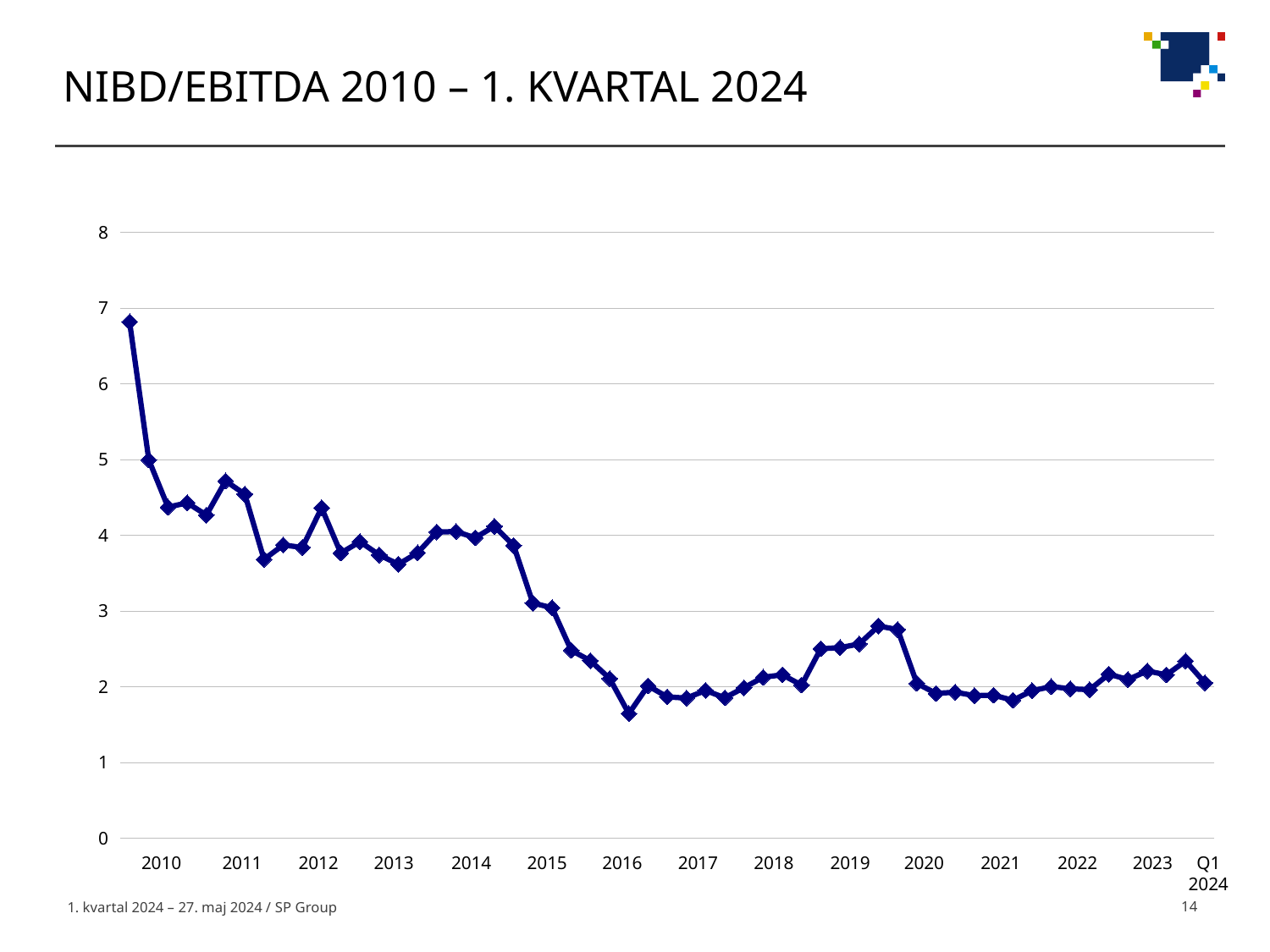
What kind of chart is shown on the slide? line chart Is the highest point in 2011 greater or less than 4? greater Is the value at the start of 2020 greater or less than 3? less Is the first plotted value in 2010 greater or less than 6? greater How many labels are shown on the x axis? 15 In which year does the line reach its highest value? 2010 Which is larger, the first value in 2010 or the first value in 2014? 2010 What is the title of the chart? NIBD/EBITDA 2010 – 1. KVARTAL 2024 In which year does the line reach its lowest value? 2016 Overall, do the values rise or fall from 2010 to Q1 2024? fall